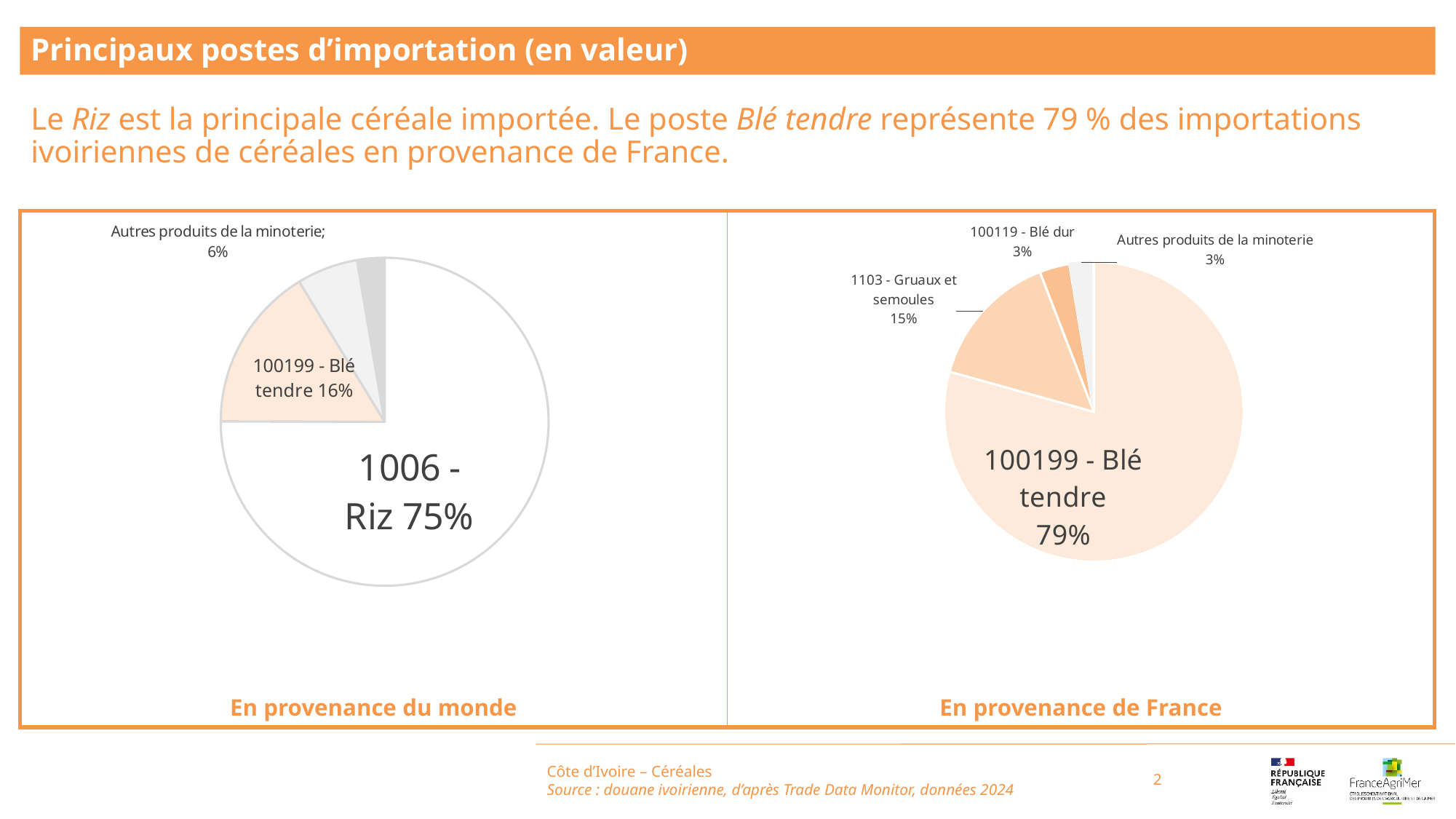
How many slices does the 'En provenance de France' pie chart have? 4 Is the share of '100199 - Blé tendre' larger in the 'En provenance du monde' chart or in the 'En provenance de France' chart? En provenance de France In the 'En provenance de France' pie chart, what share does '1103 - Gruaux et semoules' represent? 15% In the 'En provenance de France' pie chart, what share does '100199 - Blé tendre' represent? 79% In the 'En provenance du monde' pie chart, what share does 'Autres produits de la minoterie' represent? 6% In the 'En provenance de France' pie chart, which category has the largest share? 100199 - Blé tendre In the 'En provenance de France' pie chart, what share does '100119 - Blé dur' represent? 3% In the 'En provenance de France' pie chart, how many percentage points larger is the share of '100199 - Blé tendre' than that of '1103 - Gruaux et semoules'? 64 percentage points What type of chart is used for 'En provenance du monde'? Pie chart In the 'En provenance du monde' pie chart, which category has the largest share? 1006 - Riz In the 'En provenance du monde' pie chart, what share does '100199 - Blé tendre' represent? 16% In the 'En provenance du monde' pie chart, what share does '1006 - Riz' represent? 75%